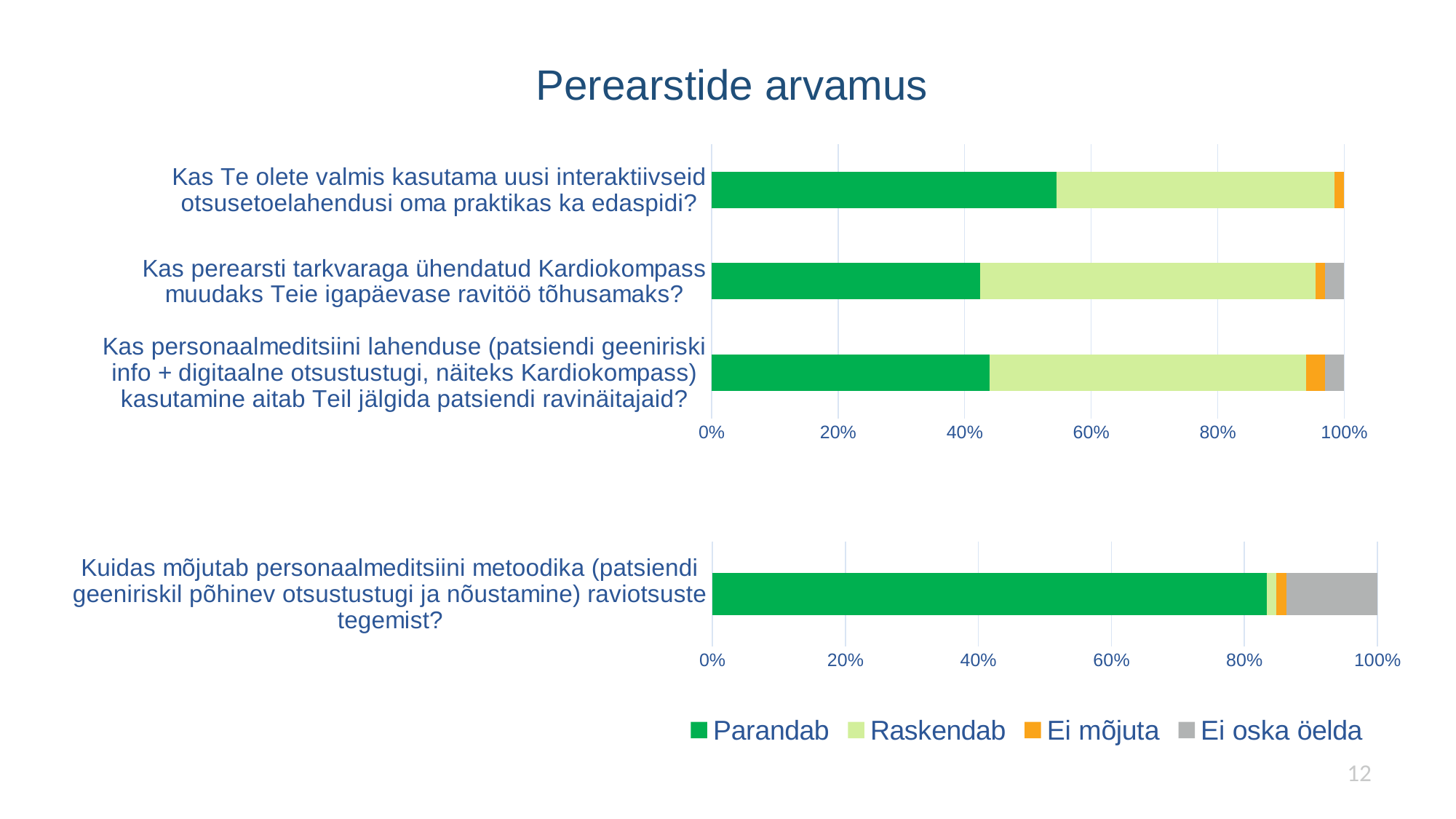
In the top chart, is the Parandab share for "Kas Te olete valmis kasutama uusi interaktiivseid otsusetoelahendusi oma praktikas ka edaspidi?" greater or less than 40%? greater In the bottom chart, is the Parandab share greater or less than 60%? greater What kind of chart is the top chart on the slide? bar chart What is the title of the slide above the charts? Perearstide arvamus How many question categories are plotted in the top chart? 3 Which colour represents the Ei mõjuta series in the legend? orange In the top chart, is the Parandab share for "Kas perearsti tarkvaraga ühendatud Kardiokompass muudaks Teie igapäevase ravitöö tõhusamaks?" greater or less than 60%? less How many question categories are plotted in the bottom chart? 1 In the top chart, which has the larger Parandab share: "Kas Te olete valmis kasutama uusi interaktiivseid otsusetoelahendusi oma praktikas ka edaspidi?" or "Kas perearsti tarkvaraga ühendatud Kardiokompass muudaks Teie igapäevase ravitöö tõhusamaks?" Kas Te olete valmis kasutama uusi interaktiivseid otsusetoelahendusi oma praktikas ka edaspidi? How many series does the legend at the bottom of the slide list? 4 In the top chart, which question has the largest Parandab share? Kas Te olete valmis kasutama uusi interaktiivseid otsusetoelahendusi oma praktikas ka edaspidi?